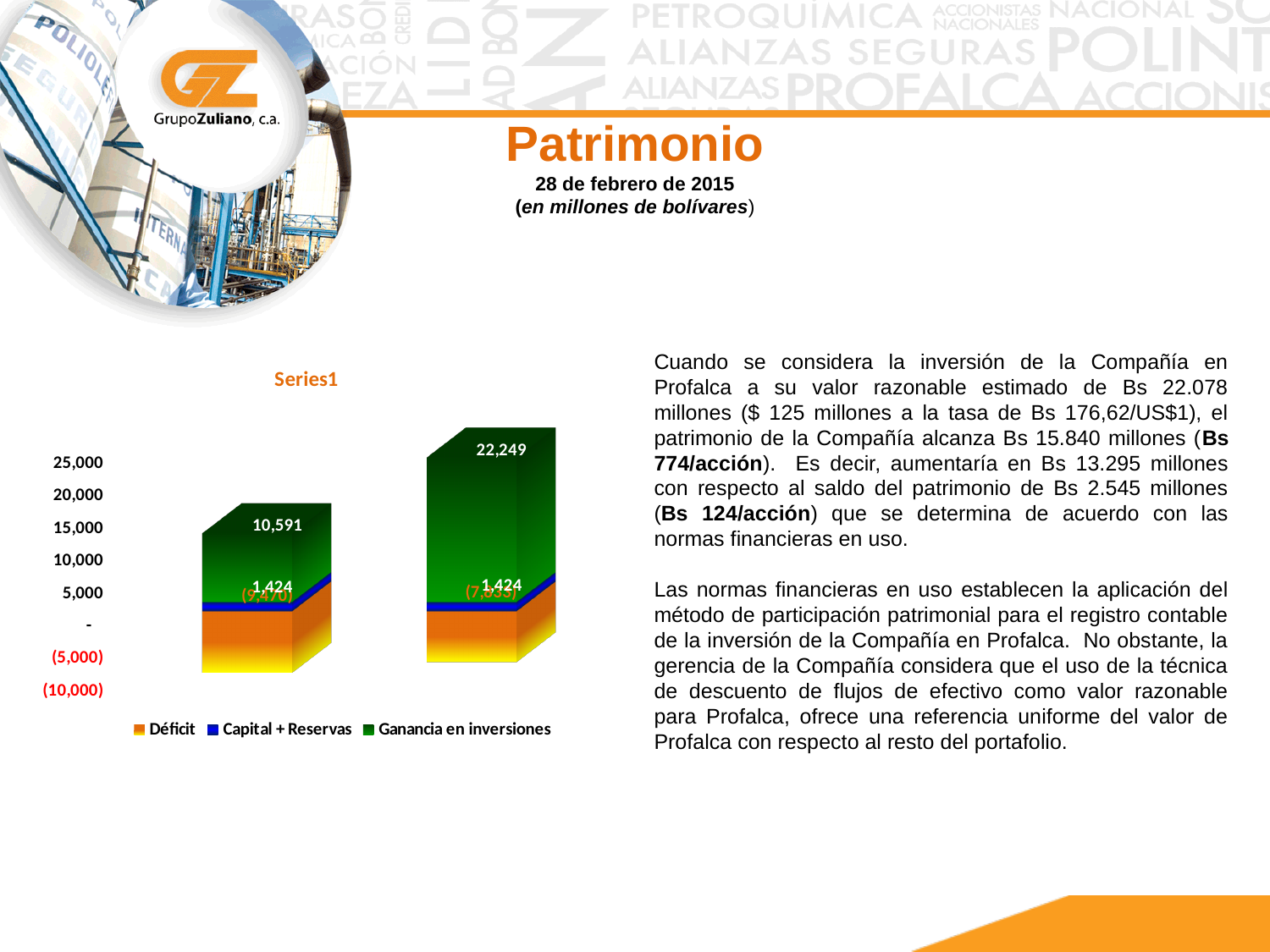
What is the Ganancia en inversiones value for the right bar? 22,249 Does the Ganancia en inversiones value rise or fall from the left bar to the right bar? Rise What is the title shown above the chart? Series1 What is the Ganancia en inversiones value for the left bar? 10,591 Is the Ganancia en inversiones value for the right bar greater or less than 20,000? greater What kind of chart is shown on the slide? Bar chart What is the Capital + Reservas value for the left bar? 1,424 What is the difference between the Ganancia en inversiones values of the right bar (22,249) and the left bar (10,591)? 11,658 How many stacked bars are plotted in the chart? 2 Which bar has the larger Ganancia en inversiones value, the left or the right? Right bar How many series does the chart legend list? 3 Which colour represents Ganancia en inversiones in the chart legend? Green